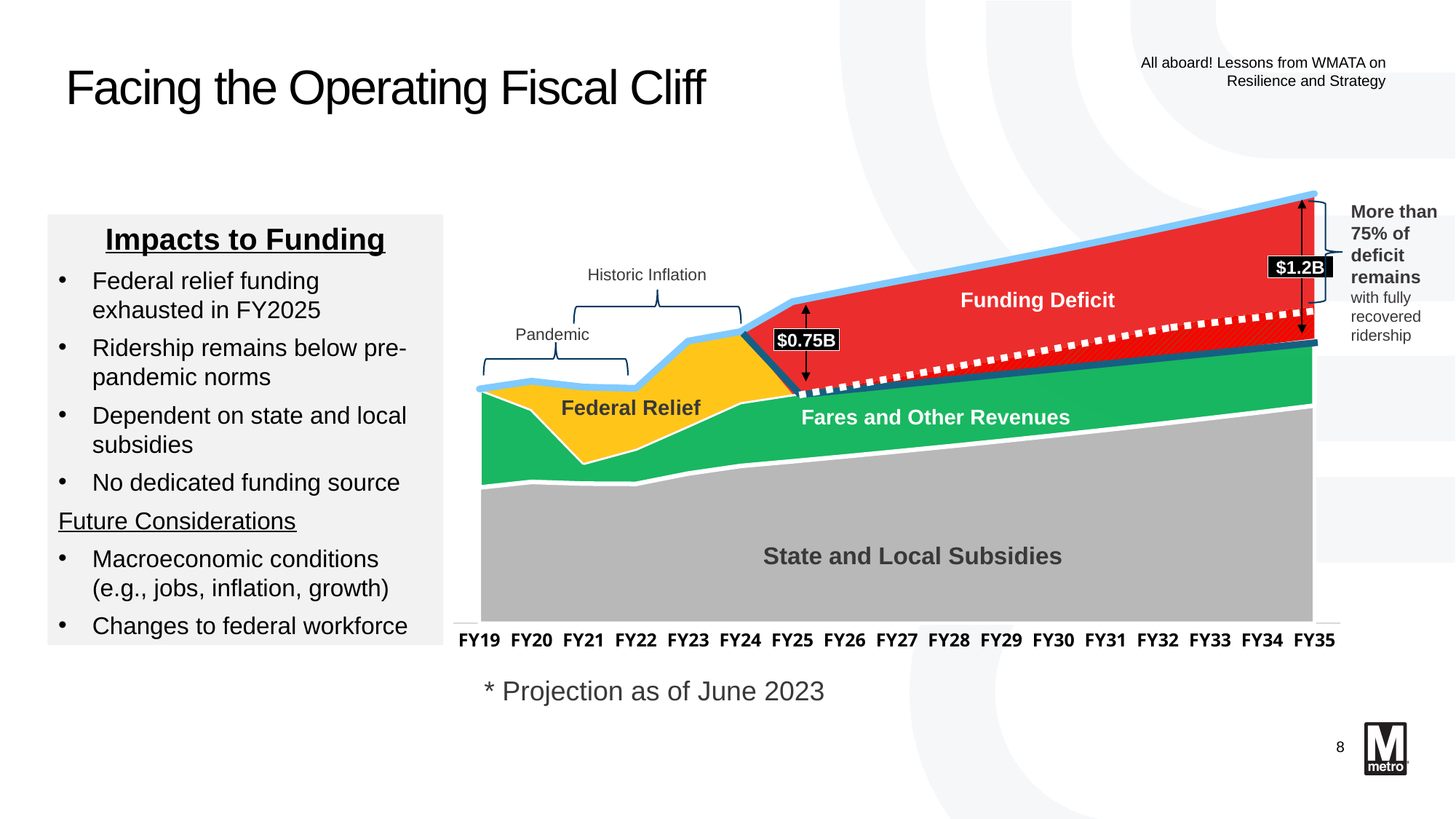
What is the labelled funding deficit value shown at FY25? $0.75B By how much does the labelled funding deficit grow from FY25 ($0.75B) to FY35 ($1.2B)? $0.45B What colour is the Fares and Other Revenues area? Green In which fiscal year does the Funding Deficit area first appear? FY25 Does the Funding Deficit area rise or fall from FY25 to FY35? Rises What is the labelled funding deficit value shown at FY35? $1.2B How many fiscal years are shown along the x axis? 17 Which funding component forms the bottom (grey) layer of the chart? State and Local Subsidies What is the last fiscal year in which the Federal Relief area is shown? FY24 Is the labelled funding deficit larger in FY25 or in FY35? FY35 What kind of chart is used to show the funding picture? Stacked area chart What two period annotations are bracketed above the chart? Pandemic and Historic Inflation